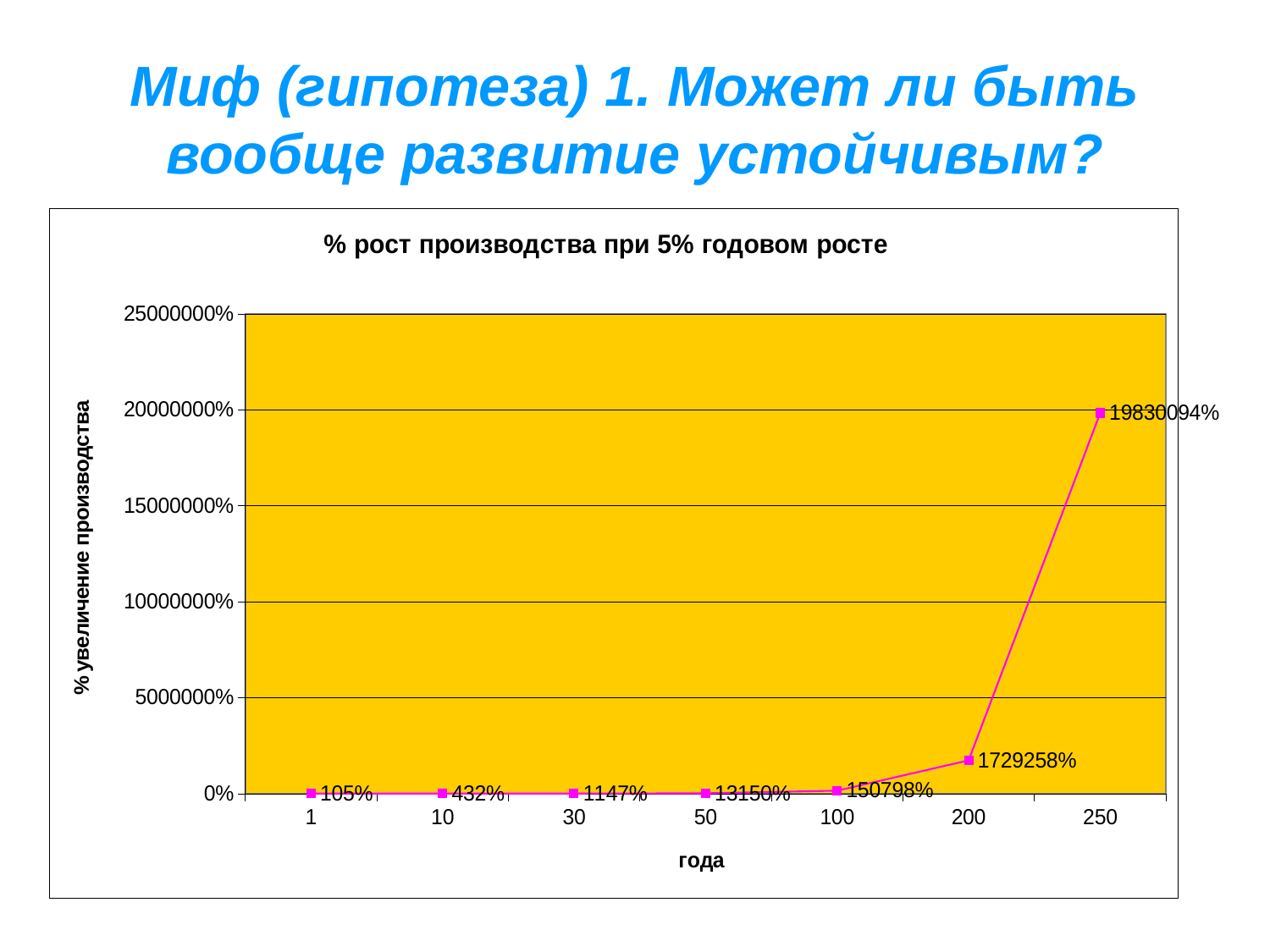
Which year on the x axis has the highest value? 250 What is the value plotted for year 250? 19830094% What is the value plotted for year 200? 1729258% What is the value plotted for year 50? 13150% Is the value for year 250 greater or less than 15000000%? greater How many data points are plotted on the chart? 7 What is the value plotted for year 1? 105% Do the values rise or fall as the years increase along the x axis? rise Which year on the x axis has the lowest value? 1 What is the title of the chart? % рост производства при 5% годовом росте What type of chart is shown on the slide? line chart Which is larger, the value for year 100 or the value for year 200? year 200